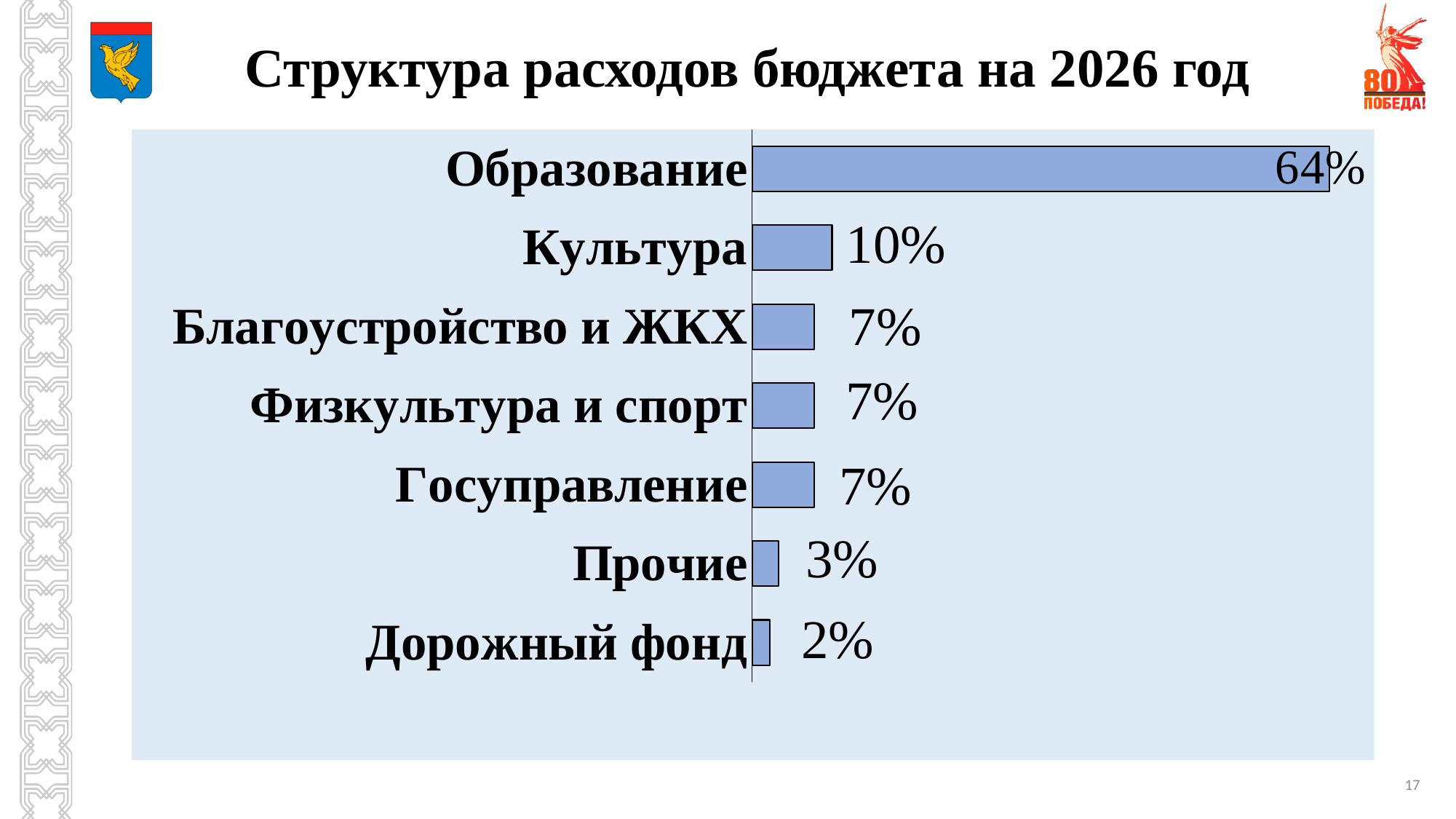
What kind of chart is shown on the slide? Bar chart Which is larger, the value for Культура or the value for Госуправление? Культура What is the value for Прочие? 3% What is the value for Дорожный фонд? 2% What is the difference between the values for Прочие and Дорожный фонд? 1% What is the title of the slide? Структура расходов бюджета на 2026 год Which category has the lowest value? Дорожный фонд What is the difference between the values for Образование and Культура? 54% Which category has the highest value? Образование What is the value for Образование? 64% What is the value for Культура? 10% How many categories are shown in the chart? 7